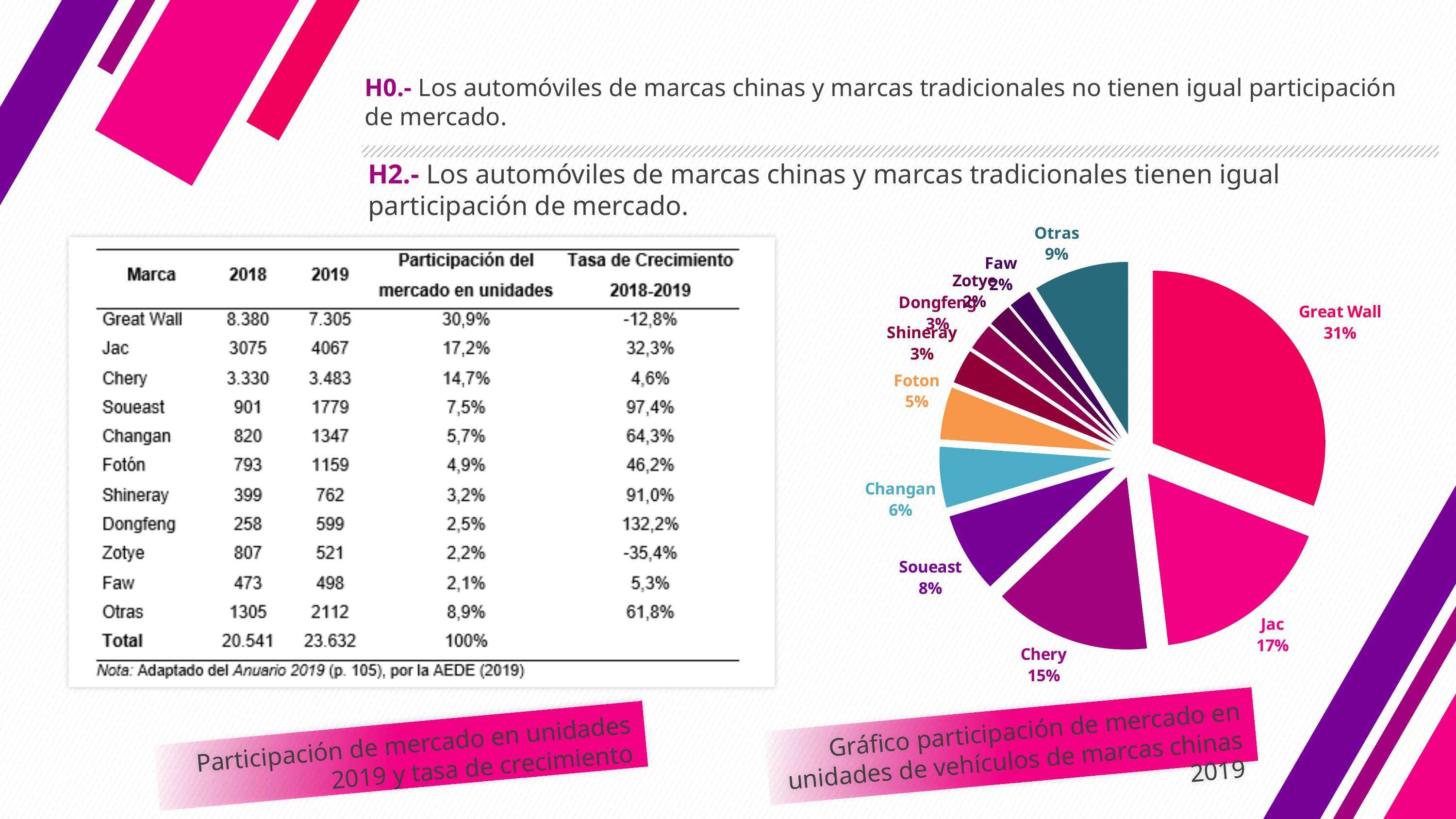
What is the title shown below the pie chart? Gráfico participación de mercado en unidades de vehículos de marcas chinas 2019 Which brand has the largest slice in the pie chart? Great Wall How many slices does the pie chart have? 11 In the pie chart, what share does Jac have? 17% In the pie chart, what share does Otras have? 9% In the pie chart, what share does Great Wall have? 31% In the pie chart, what share does Foton have? 5% In the pie chart, what share does Chery have? 15% In the pie chart, which slice is larger, Soueast or Changan? Soueast In the pie chart, what is the difference between the shares of Great Wall and Jac? 14% What kind of chart is shown on the right of the slide? pie chart In the pie chart, what is the difference between the shares of Chery and Soueast? 7%